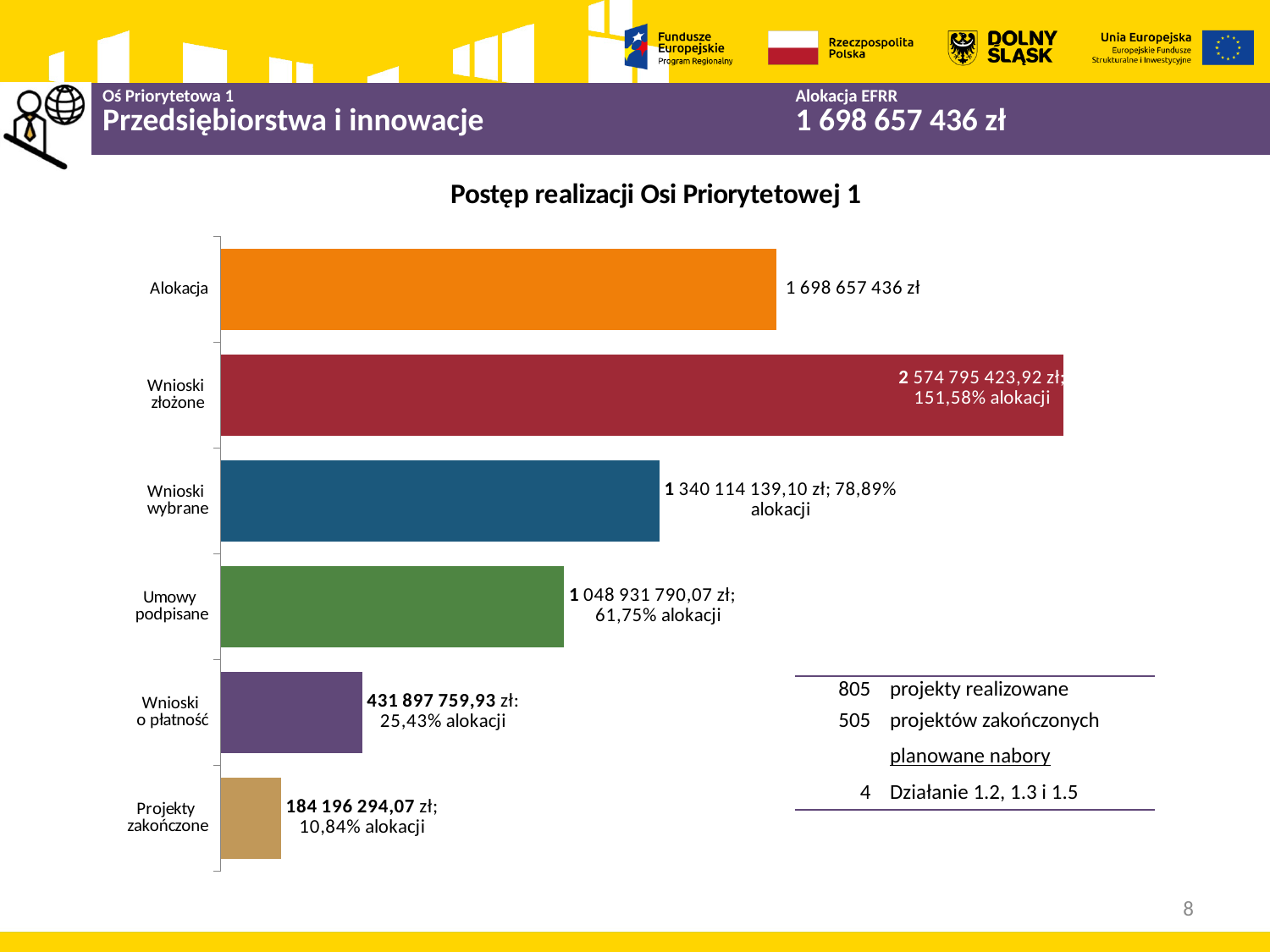
Which category has the highest value? Wnioski złożone What is the difference in percentage points between the share of allocation for Wnioski wybrane and Umowy podpisane? 17,14 What is the title of the chart? Postęp realizacji Osi Priorytetowej 1 What percentage of the allocation do Umowy podpisane represent? 61,75% How many categories are plotted in the chart? 6 What is the value shown for Projekty zakończone? 184 196 294,07 zł What type of chart is shown on the slide? bar chart What is the difference between Alokacja and Umowy podpisane? 649 725 645,93 zł What is the value shown for Wnioski złożone? 2 574 795 423,92 zł Which category has the lowest value? Projekty zakończone Which is larger, Alokacja or Wnioski wybrane? Alokacja What is the value shown for Alokacja? 1 698 657 436 zł